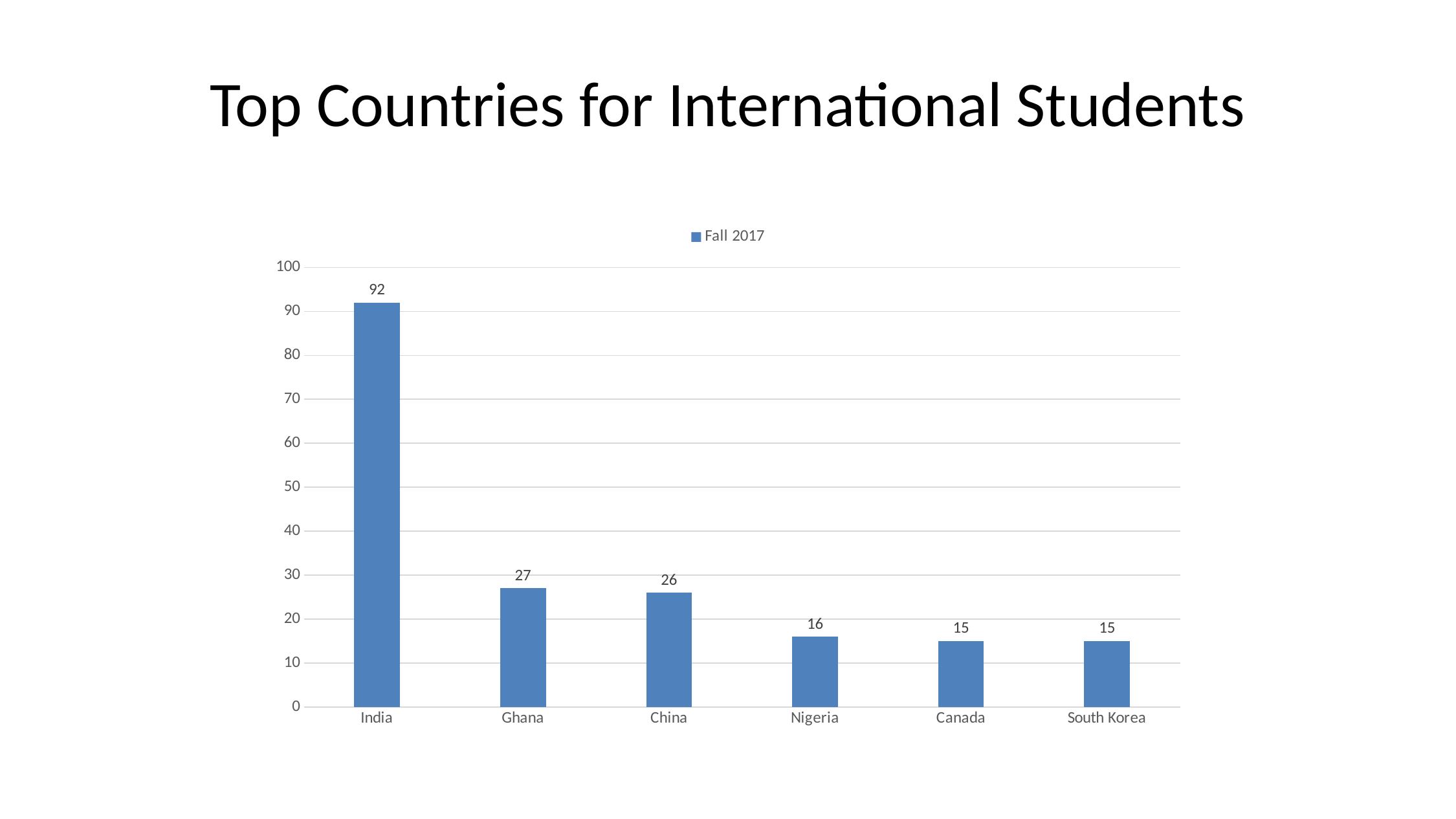
How many countries are shown on the x axis? 6 What is the name of the series in the legend? Fall 2017 What is the difference between the values for Ghana and Nigeria? 11 How many series does the legend list? 1 Which is larger, the value for China or the value for Canada? China What is the value for India? 92 Is the value for India greater or less than 50? greater Which country has the highest value? India What kind of chart is shown on the slide? bar chart What is the difference between the values for India and China? 66 What is the value for Nigeria? 16 What is the value for Ghana? 27